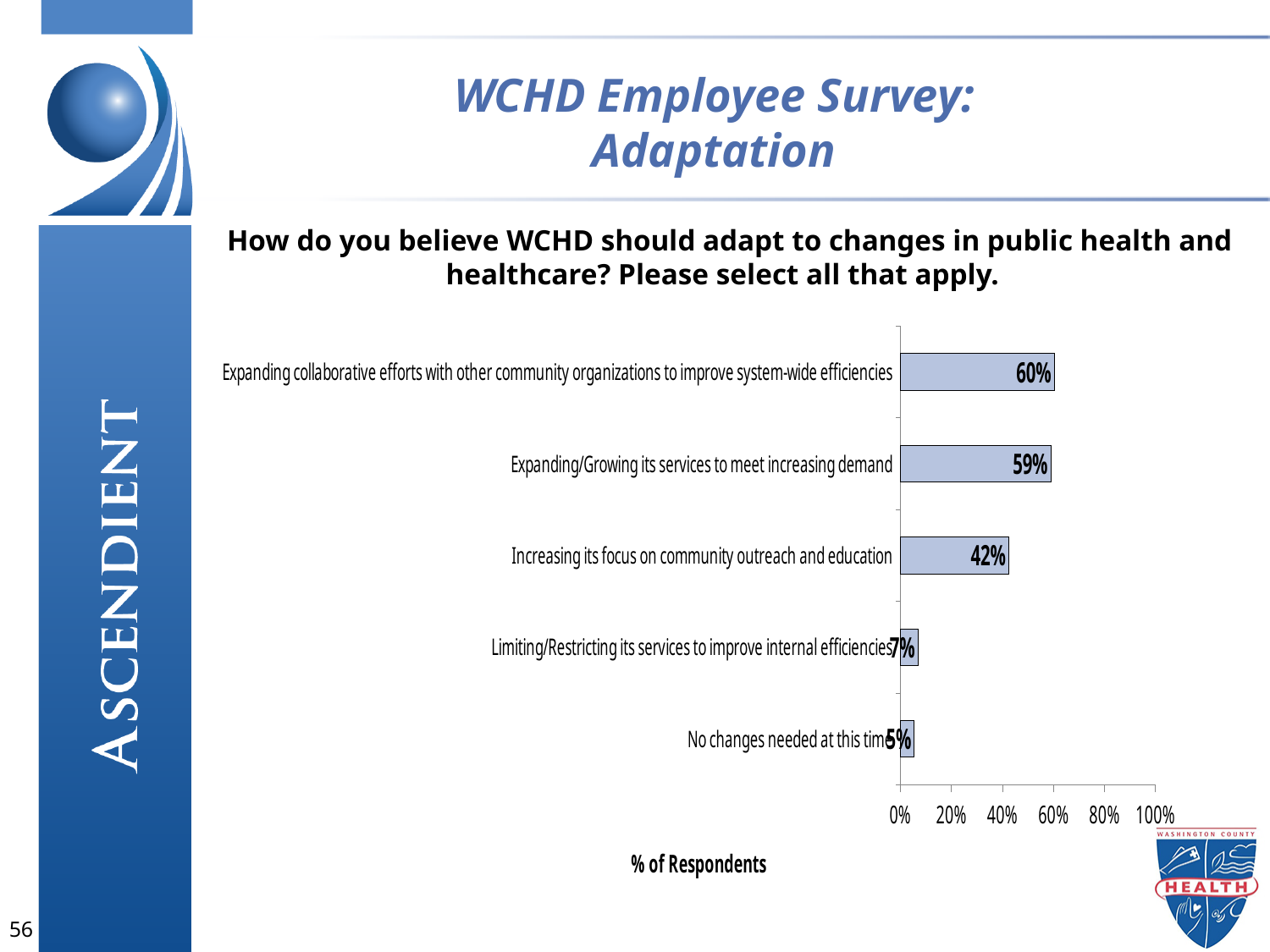
Which response option has the lowest percentage of respondents? No changes needed at this time Which has a larger share of respondents: 'Increasing its focus on community outreach and education' or 'Limiting/Restricting its services to improve internal efficiencies'? Increasing its focus on community outreach and education Which response option has the highest percentage of respondents? Expanding collaborative efforts with other community organizations to improve system-wide efficiencies What type of chart is used on this slide? Bar chart What percentage of respondents selected 'Expanding collaborative efforts with other community organizations to improve system-wide efficiencies'? 60% What percentage of respondents selected 'Limiting/Restricting its services to improve internal efficiencies'? 7% What percentage of respondents selected 'No changes needed at this time'? 5% What percentage of respondents selected 'Increasing its focus on community outreach and education'? 42% How many response options are shown in the chart? 5 What is the label of the horizontal axis of the chart? % of Respondents What is the difference in percentage points between 'Expanding/Growing its services to meet increasing demand' and 'Increasing its focus on community outreach and education'? 17 percentage points What percentage of respondents selected 'Expanding/Growing its services to meet increasing demand'? 59%